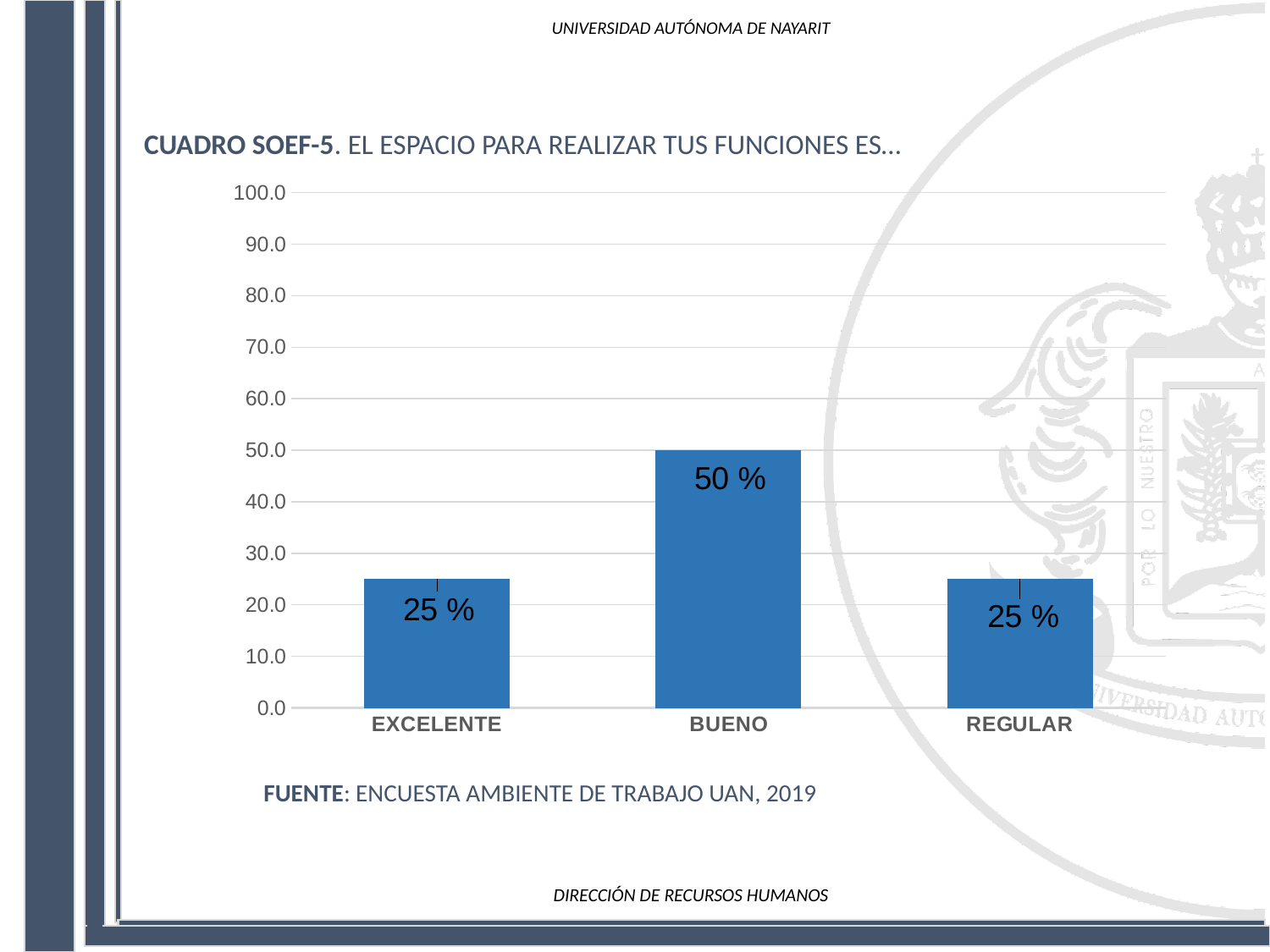
Which category has the highest value? BUENO Which is larger, the value for BUENO or the value for REGULAR? BUENO What kind of chart is shown on the slide? bar chart How many categories are shown on the x axis? 3 What is the value for REGULAR? 25 % What is the maximum value shown on the vertical axis? 100.0 What is the value for BUENO? 50 % Is the value for BUENO greater or less than 40? greater Is the value for EXCELENTE greater or less than 30? less What is the difference between the values for BUENO and EXCELENTE? 25 % What is the value for EXCELENTE? 25 % What is the source cited below the chart? ENCUESTA AMBIENTE DE TRABAJO UAN, 2019